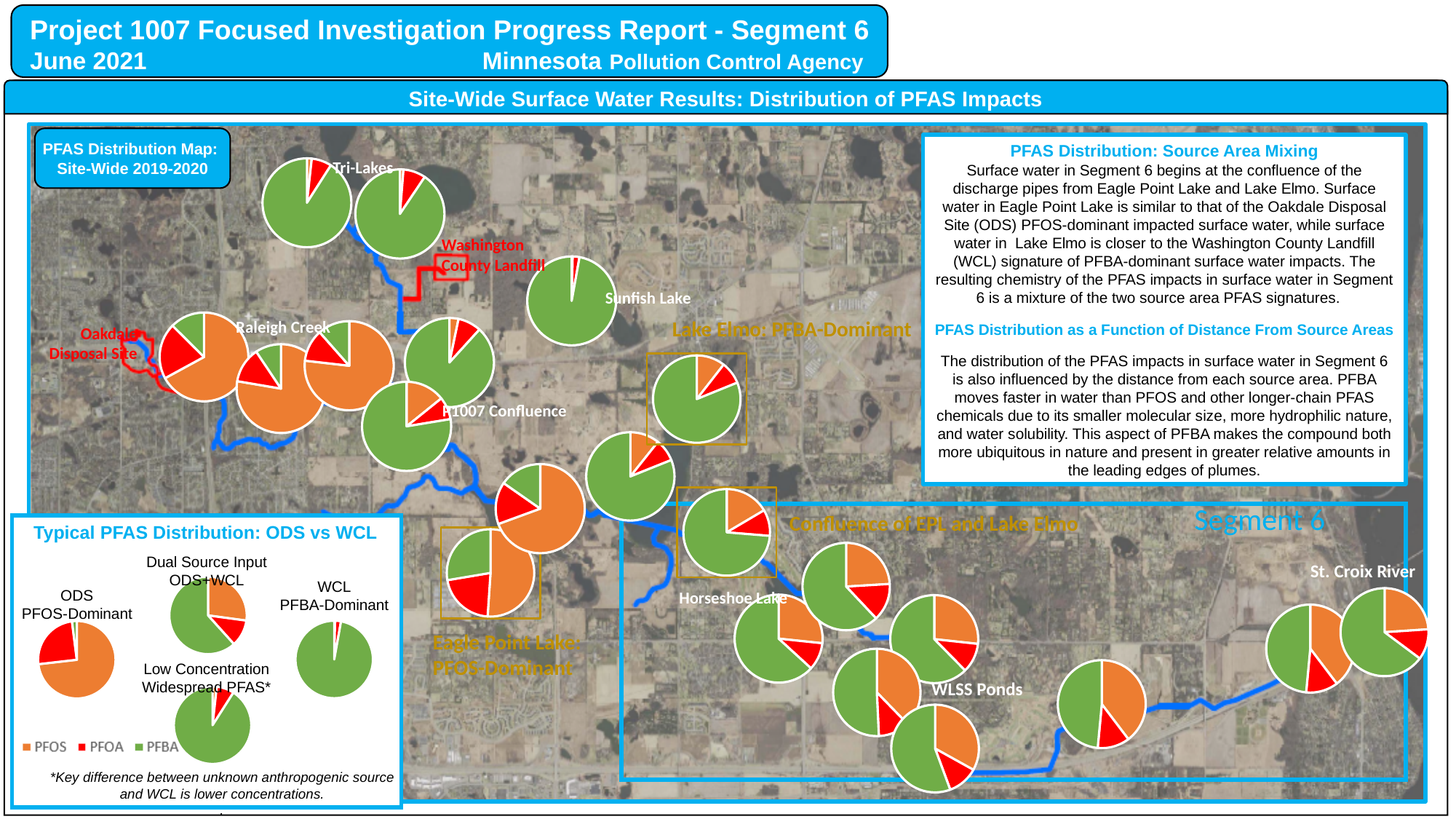
In the 'WCL PFBA-Dominant' pie chart in the inset, which compound has the smallest slice? PFOS In the 'ODS PFOS-Dominant' pie chart in the inset, which compound has the largest slice? PFOS How many series does the legend in the 'Typical PFAS Distribution: ODS vs WCL' inset list? 3 What kind of chart is used to show the PFAS distribution at each location on the map? Pie chart In the 'Dual Source Input ODS+WCL' pie chart in the inset, which slice is larger, PFBA or PFOA? PFBA What colour represents PFBA in the pie chart legend? Green In the Sunfish Lake pie chart on the map, which slice is larger, PFBA or PFOA? PFBA What is the title of the inset box containing the four example pie charts? Typical PFAS Distribution: ODS vs WCL In the 'ODS PFOS-Dominant' pie chart in the inset, which slice is larger, PFOS or PFOA? PFOS How many pie charts are shown in the 'Typical PFAS Distribution: ODS vs WCL' inset? 4 In the 'WCL PFBA-Dominant' pie chart in the inset, which compound has the largest slice? PFBA In the 'Low Concentration Widespread PFAS*' pie chart in the inset, which compound has the largest slice? PFBA